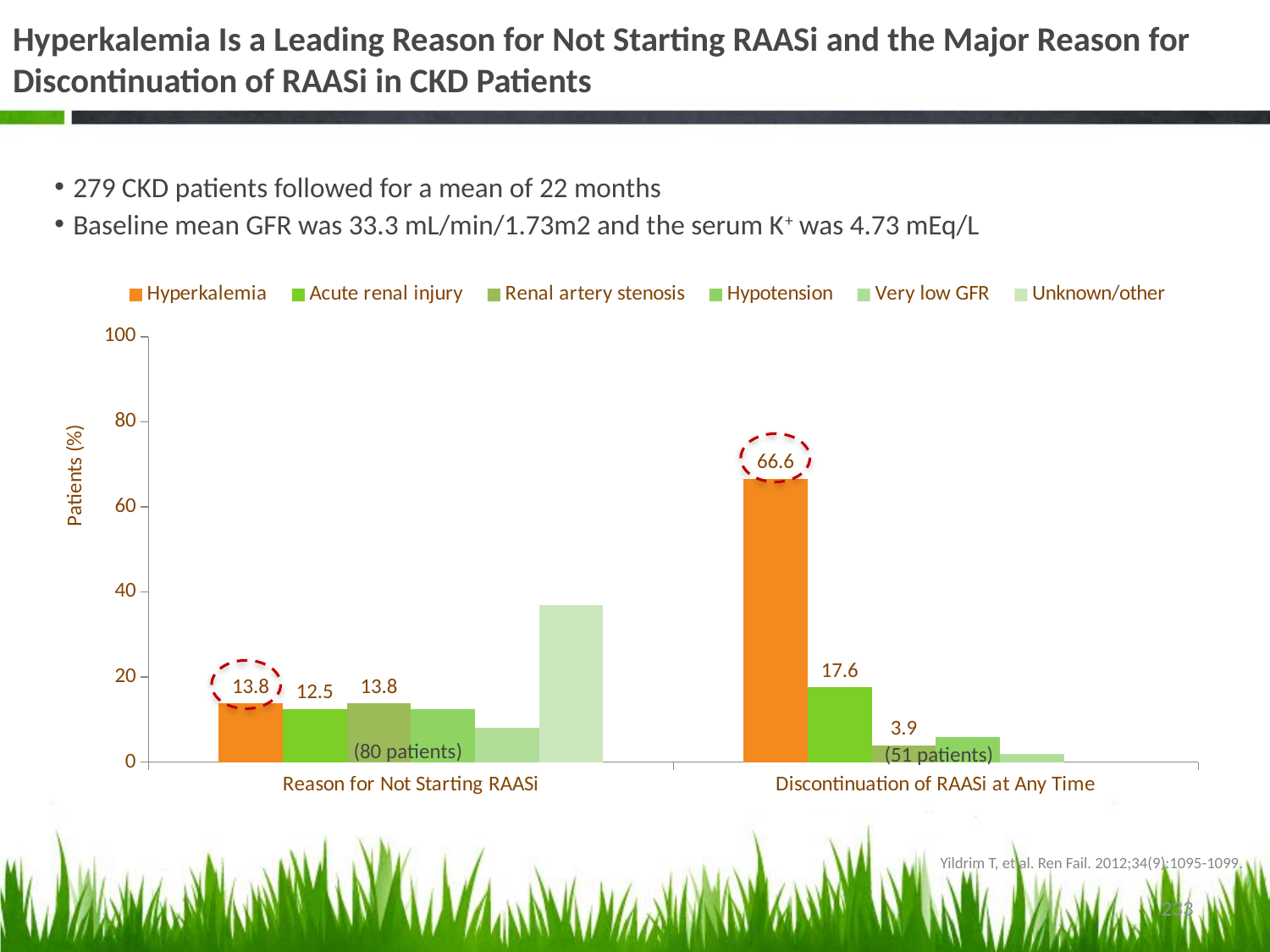
How many series does the legend list? 6 What is the value for Acute renal injury in the Reason for Not Starting RAASi group? 12.5 What kind of chart is shown on the slide? Bar chart What is the value for Renal artery stenosis in the Discontinuation of RAASi at Any Time group? 3.9 What is the difference between the Hyperkalemia and Acute renal injury values in the Discontinuation of RAASi at Any Time group? 49 Is the value for Unknown/other in the Reason for Not Starting RAASi group greater or less than 20? greater What is the value for Acute renal injury in the Discontinuation of RAASi at Any Time group? 17.6 What is the difference between the Hyperkalemia and Acute renal injury values in the Reason for Not Starting RAASi group? 1.3 What is the value for Hyperkalemia in the Discontinuation of RAASi at Any Time group? 66.6 Is the Hyperkalemia value larger for Reason for Not Starting RAASi or for Discontinuation of RAASi at Any Time? Discontinuation of RAASi at Any Time Which series has the highest value in the Reason for Not Starting RAASi group? Unknown/other Which series has the highest value in the Discontinuation of RAASi at Any Time group? Hyperkalemia